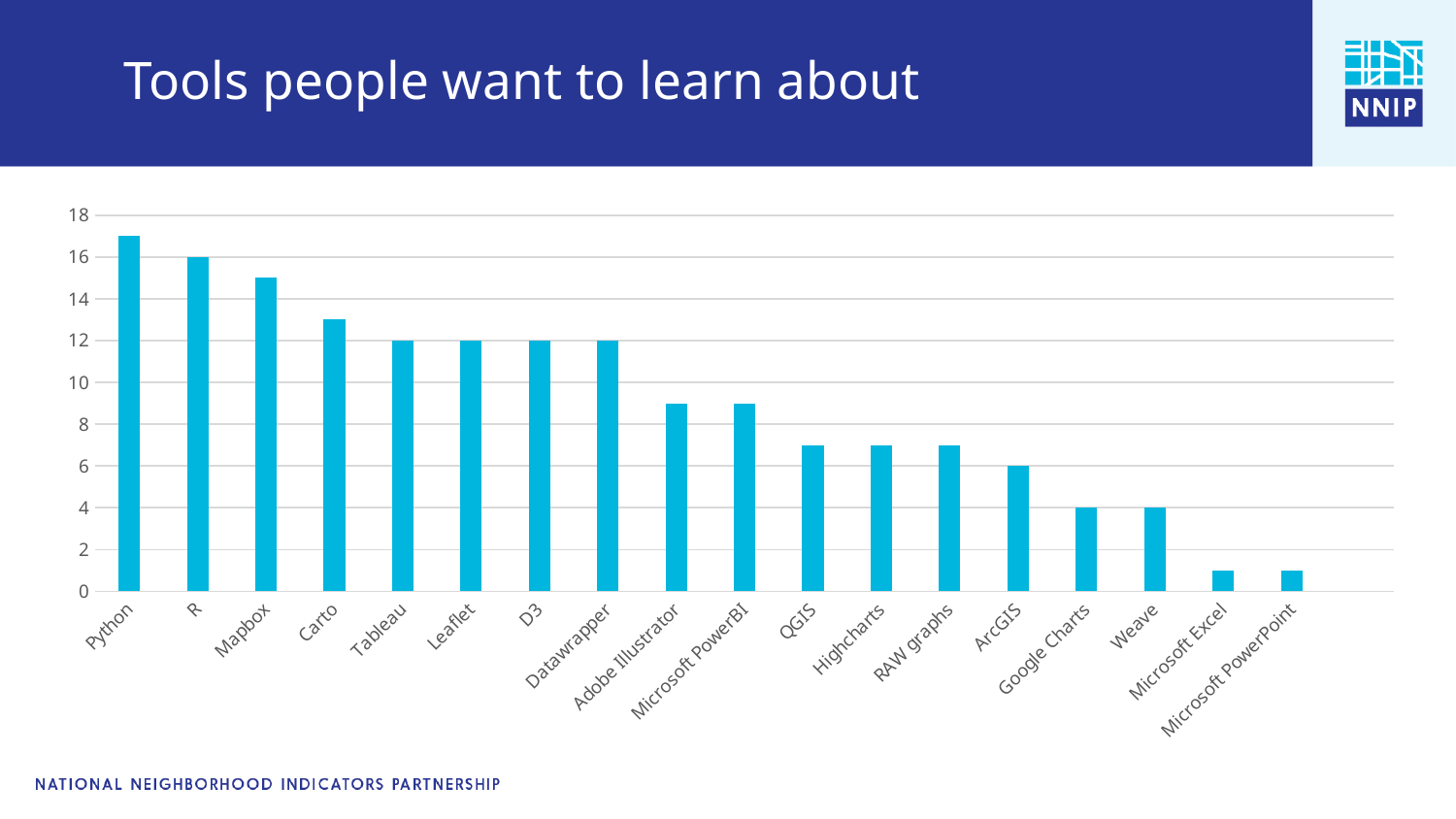
What is the value for Weave? 4 Which has a larger value, Mapbox or Carto? Mapbox What is the title of the chart? Tools people want to learn about What kind of chart is shown on the slide? bar chart Is the value for QGIS greater or less than 8? less What is the value for R? 16 How many tools are shown on the x axis of the chart? 18 What is the value for Tableau? 12 Is the value for Python greater or less than 16? greater What is the value for ArcGIS? 6 Which tool has the highest value in the chart? Python What is the difference between the values for R and ArcGIS? 10